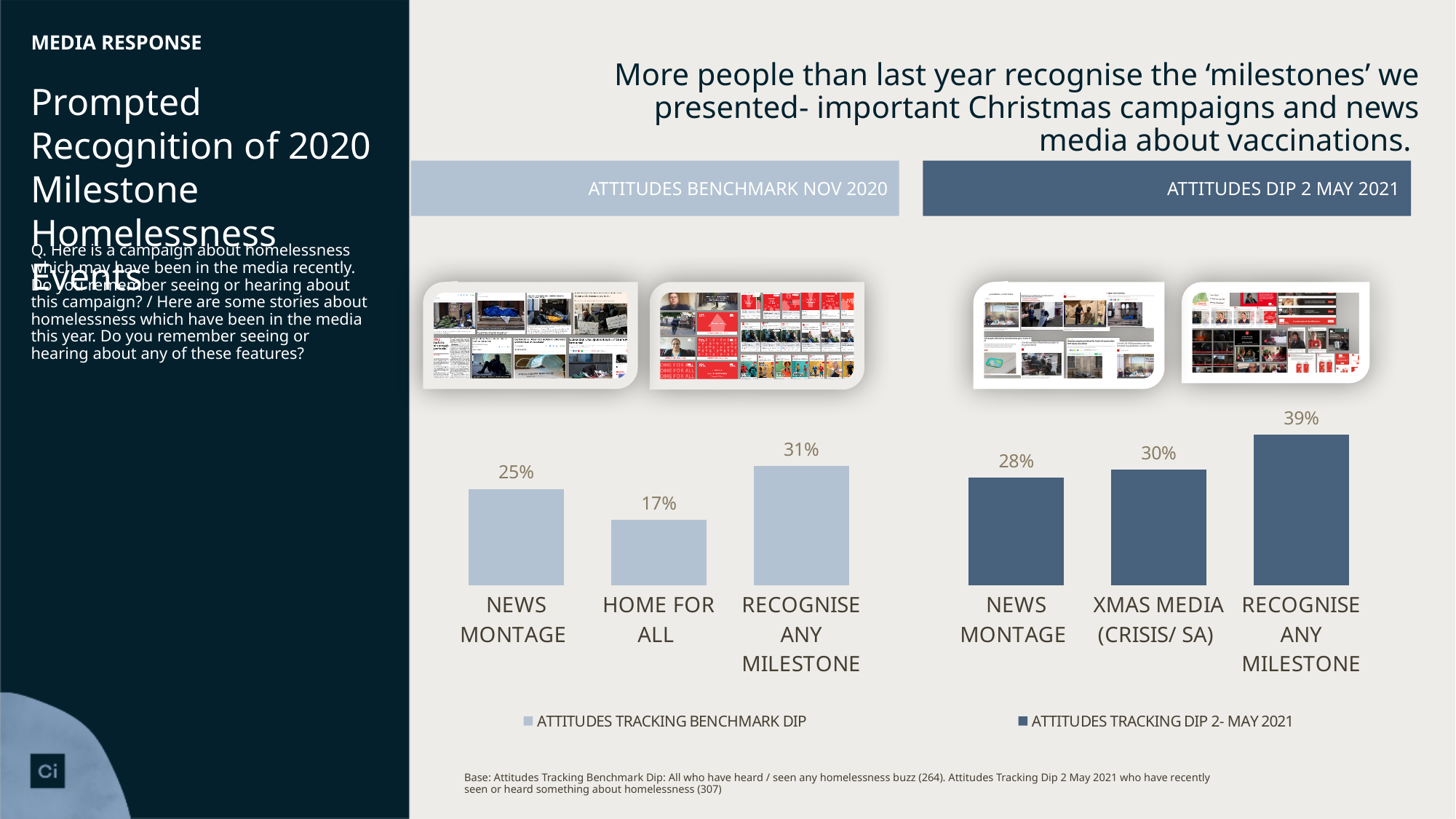
In the Attitudes Dip 2 May 2021 chart, what is the value for Xmas Media (Crisis/ SA)? 30% In the Attitudes Benchmark Nov 2020 chart, which category has the lowest value? Home for All In the Attitudes Benchmark Nov 2020 chart, what is the value for News Montage? 25% In the Attitudes Benchmark Nov 2020 chart, what is the value for Home for All? 17% In the Attitudes Benchmark Nov 2020 chart, which category has the highest value? Recognise Any Milestone In the Attitudes Dip 2 May 2021 chart, what is the difference between Recognise Any Milestone and News Montage? 11 percentage points What type of chart is the Attitudes Benchmark Nov 2020 chart? Bar chart What is the legend entry shown below the Attitudes Dip 2 May 2021 chart? ATTITUDES TRACKING DIP 2- MAY 2021 In the Attitudes Dip 2 May 2021 chart, what is the value for Recognise Any Milestone? 39% In the Attitudes Dip 2 May 2021 chart, which category has the lowest value? News Montage How many categories are shown in the Attitudes Dip 2 May 2021 chart? 3 Which is larger: News Montage in the Attitudes Benchmark Nov 2020 chart or News Montage in the Attitudes Dip 2 May 2021 chart? Attitudes Dip 2 May 2021